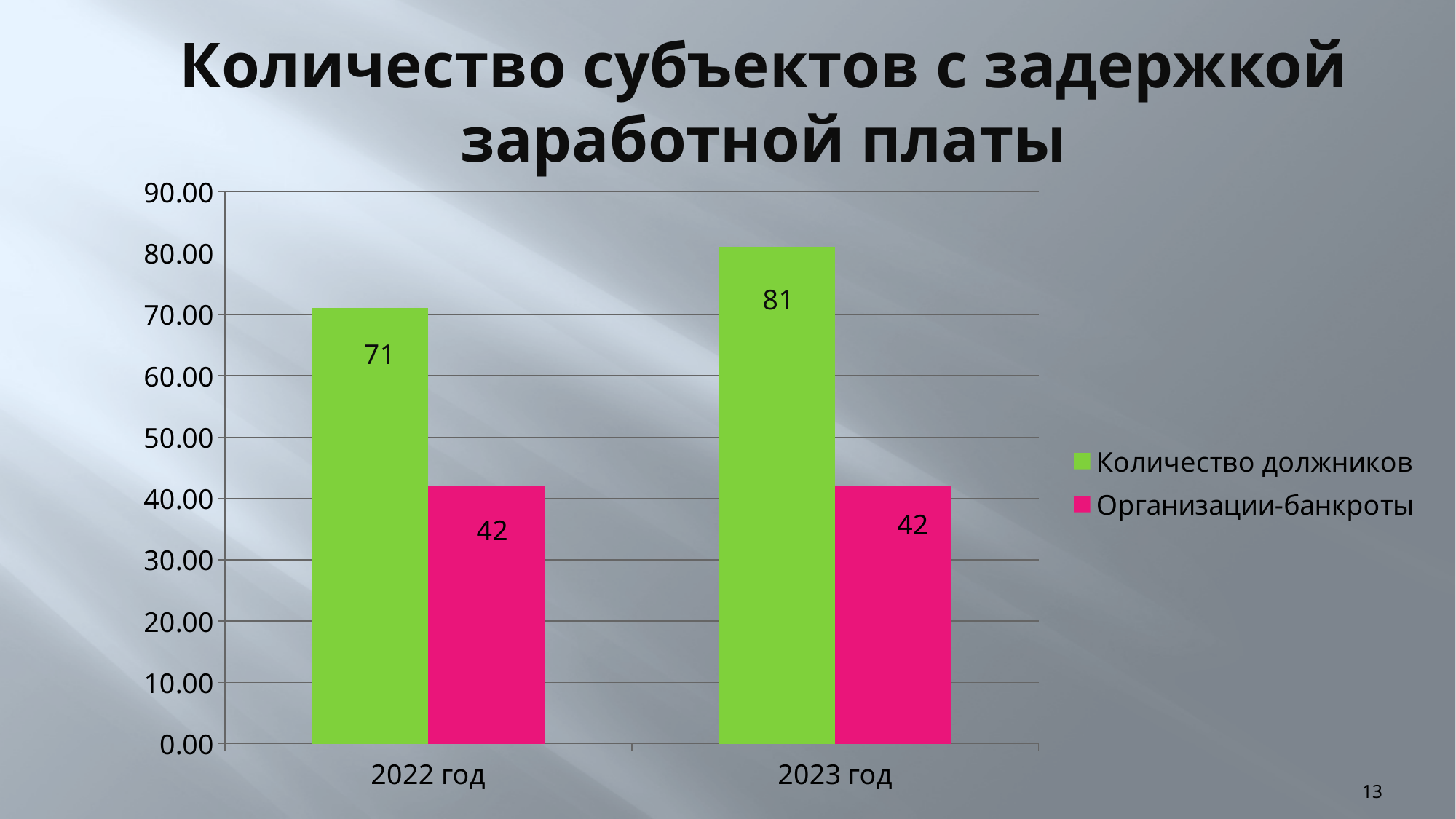
Which is larger in 2023 год: Количество должников or Организации-банкроты? Количество должников What is the difference between Количество должников in 2023 год and 2022 год? 10 What kind of chart is shown on the slide? bar chart What is the value of Организации-банкроты for 2022 год? 42 How many series does the legend list? 2 What is the value of Организации-банкроты for 2023 год? 42 What is the value of Количество должников for 2022 год? 71 How many categories are shown on the x axis? 2 In which year is Количество должников highest? 2023 год What is the difference between Количество должников and Организации-банкроты in 2022 год? 29 Is the value of Количество должников for 2023 год greater or less than 80.00? greater What is the value of Количество должников for 2023 год? 81